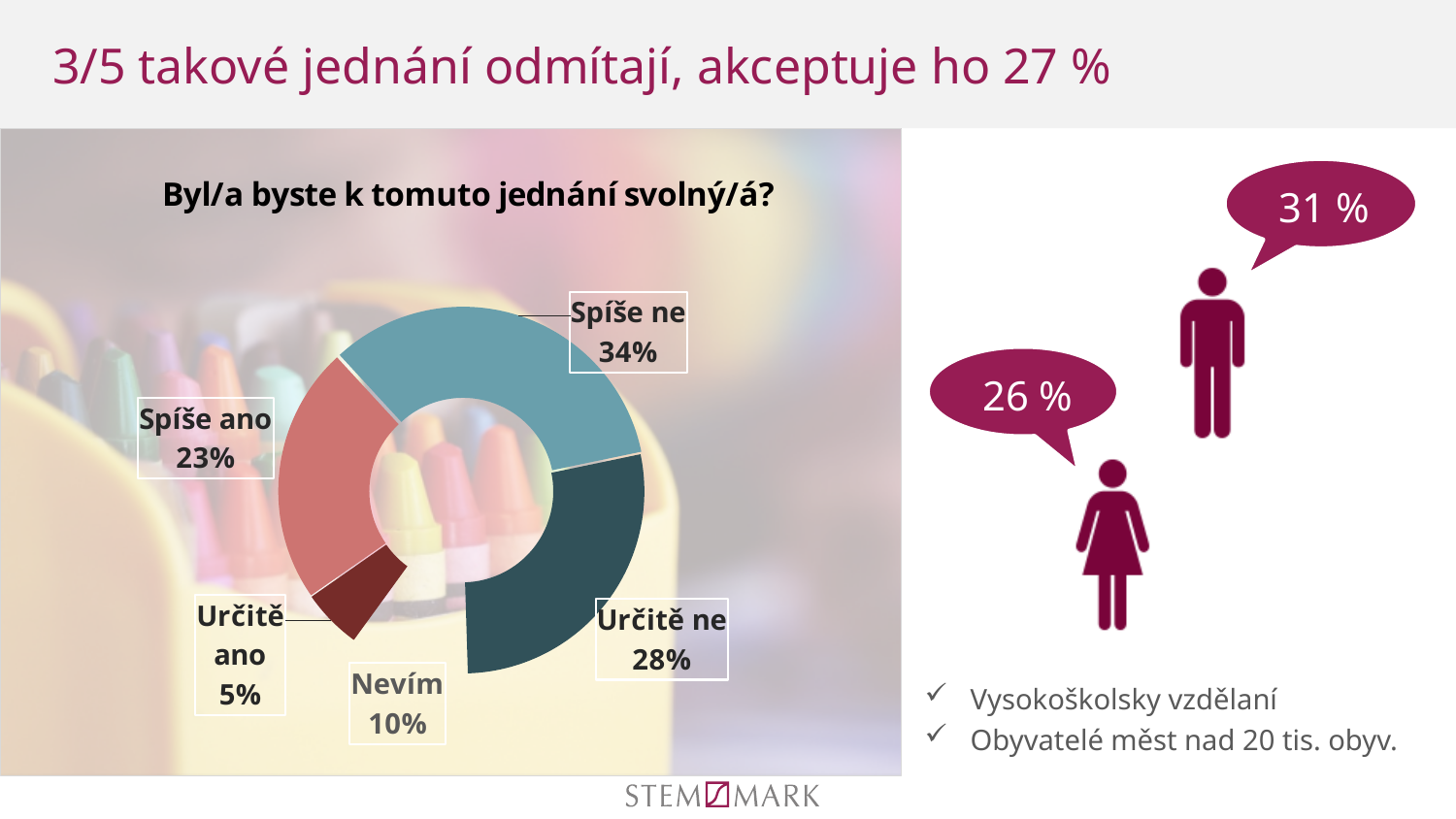
Which category has the smallest share in the chart? Určitě ano What is the difference between "Spíše ne" and "Určitě ne"? 6 percentage points What is the value for "Spíše ne" in the chart? 34% What is the value for "Nevím" in the chart? 10% What is the value for "Určitě ne" in the chart? 28% What kind of chart is shown on the slide? Donut (pie) chart Which is larger, "Spíše ano" or "Nevím"? Spíše ano How many categories does the chart show? 5 What is the value for "Určitě ano" in the chart? 5% What is the title of the chart? Byl/a byste k tomuto jednání svolný/á? Which category has the largest share in the chart? Spíše ne What is the value for "Spíše ano" in the chart? 23%